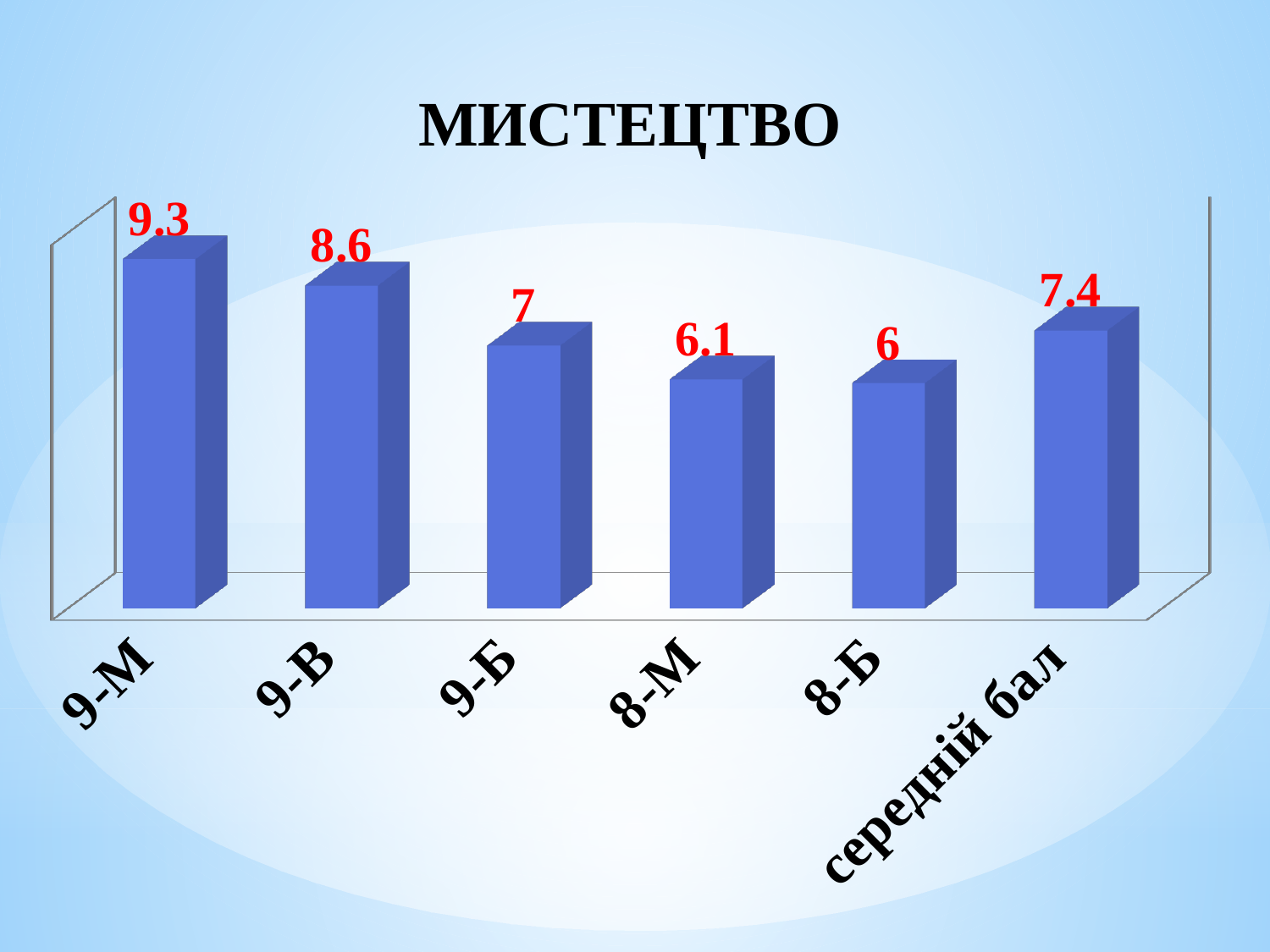
What is the difference between the values for 9-М and 9-В? 0.7 Which category has the highest value? 9-М What kind of chart is shown on the slide? bar chart What is the difference between the values for 9-Б and 8-М? 0.9 Which category has the lowest value? 8-Б What is the value for середній бал? 7.4 Do the values rise or fall from 9-М to 8-Б? fall Which is larger, the value for 9-Б or the value for середній бал? середній бал What is the value for 8-Б? 6 What is the value for 9-М? 9.3 How many categories are shown on the x axis? 6 What is the title of the chart? МИСТЕЦТВО